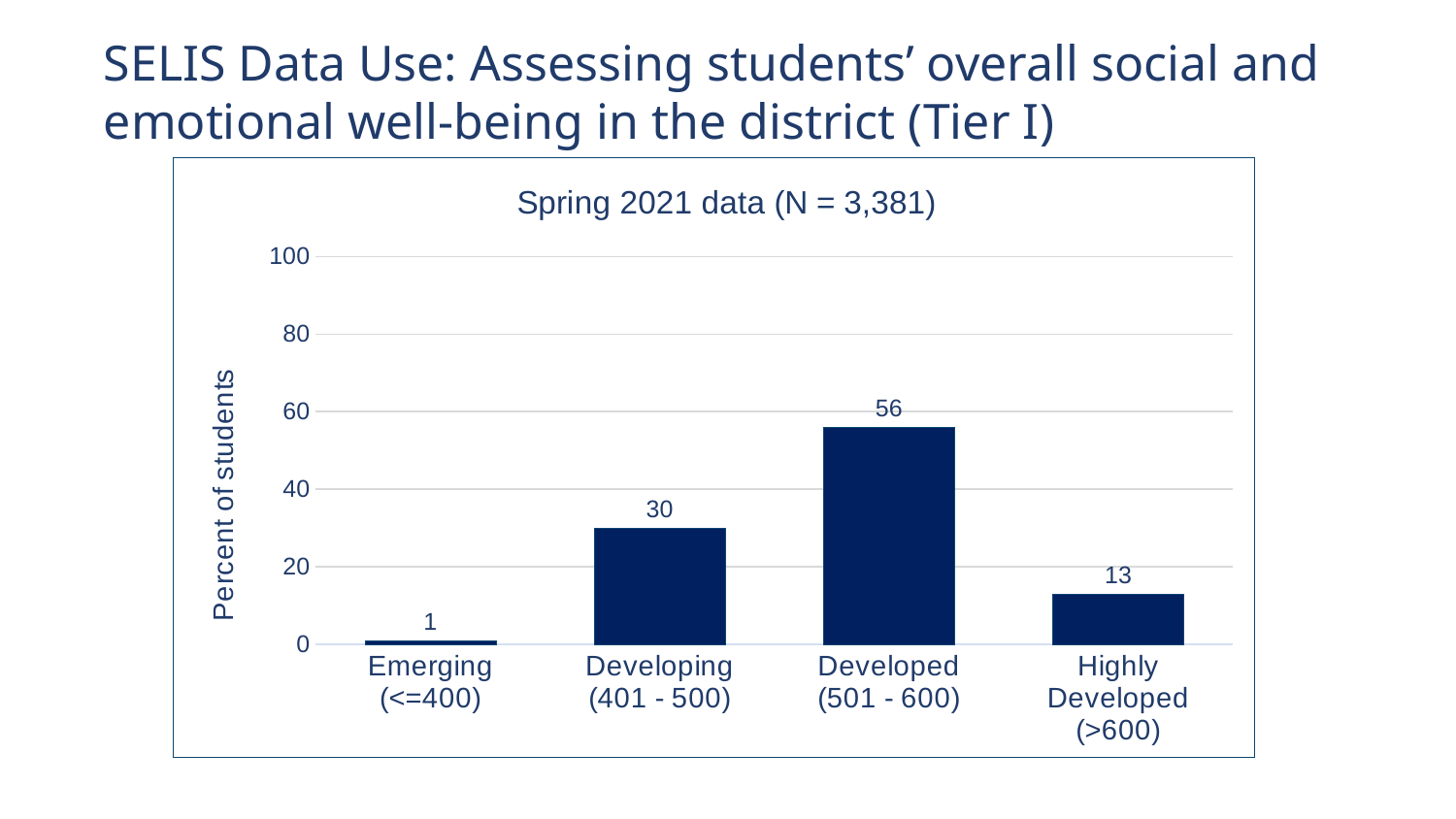
What is the value for Highly Developed (>600)? 13 What kind of chart is shown? Bar chart Which category has the highest value? Developed (501 - 600) What is the label of the y axis? Percent of students What is the value for Developed (501 - 600)? 56 What is the difference between the values for Developed and Developing? 26 What is the title of the chart? Spring 2021 data (N = 3,381) Which is larger, the value for Developing or the value for Highly Developed? Developing What is the value for Emerging (<=400)? 1 Is the value for Developed greater or less than 40? greater How many categories are shown on the x axis? 4 Which category has the lowest value? Emerging (<=400)